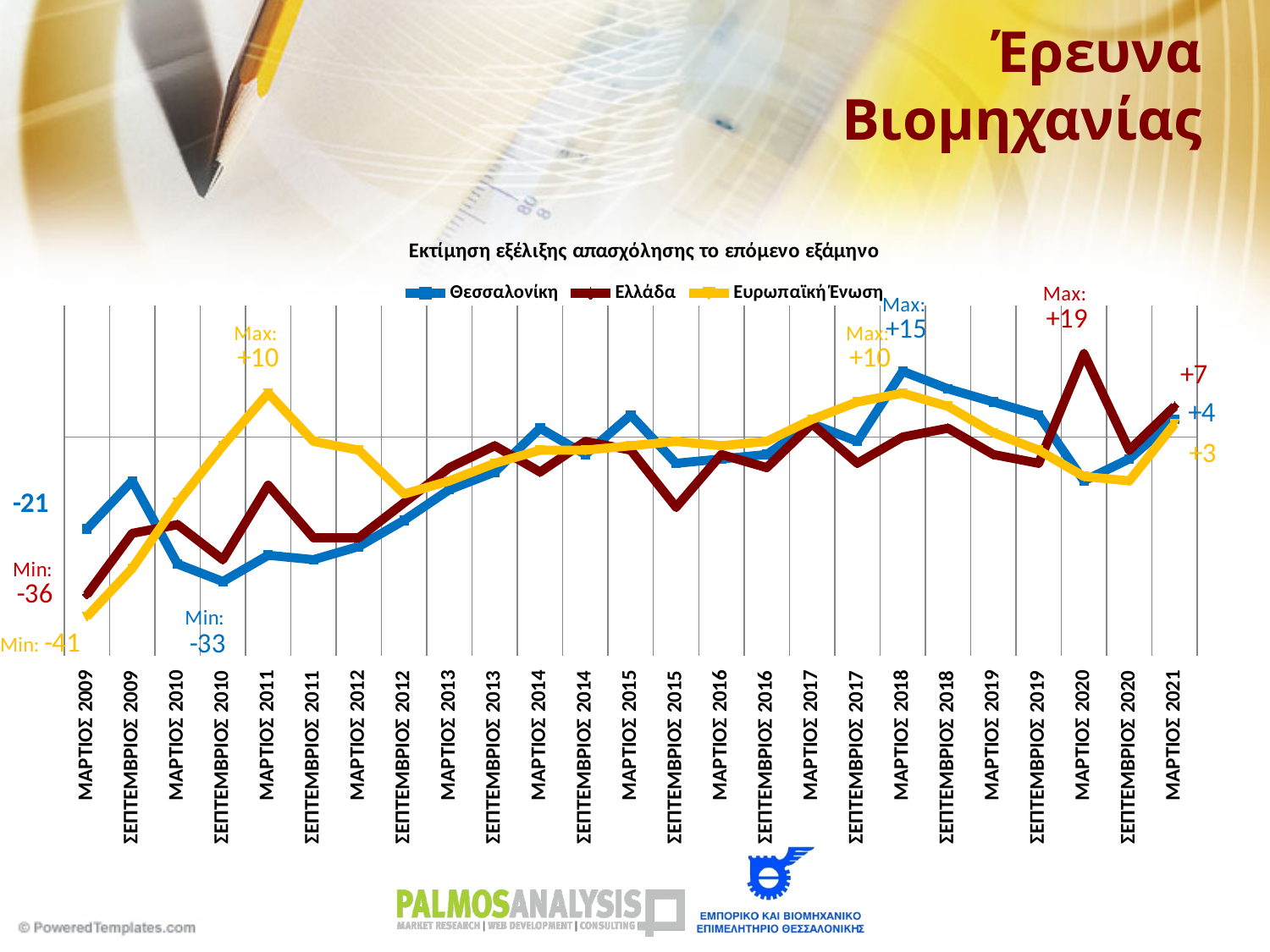
What is the value for Θεσσαλονίκη in ΜΑΡΤΙΟΣ 2009? -21 In ΜΑΡΤΙΟΣ 2021, which is larger: the value for Ελλάδα or for Ευρωπαϊκή Ένωση? Ελλάδα What is the maximum value reached by the Ελλάδα series, and in which period? +19, ΜΑΡΤΙΟΣ 2020 In which period does the Θεσσαλονίκη series reach its minimum, and what is that value? ΣΕΠΤΕΜΒΡΙΟΣ 2010, -33 What is the minimum value of the Ευρωπαϊκή Ένωση series? -41 How many series does the legend list? 3 What is the value for Θεσσαλονίκη in ΜΑΡΤΙΟΣ 2021? +4 What is the value for Ευρωπαϊκή Ένωση in ΜΑΡΤΙΟΣ 2021? +3 What kind of chart is shown on the slide? line chart What is the title of the chart? Εκτίμηση εξέλιξης απασχόλησης το επόμενο εξάμηνο What is the value for Ελλάδα in ΜΑΡΤΙΟΣ 2021? +7 In ΜΑΡΤΙΟΣ 2021, how much higher is the Ελλάδα value than the Θεσσαλονίκη value? 3